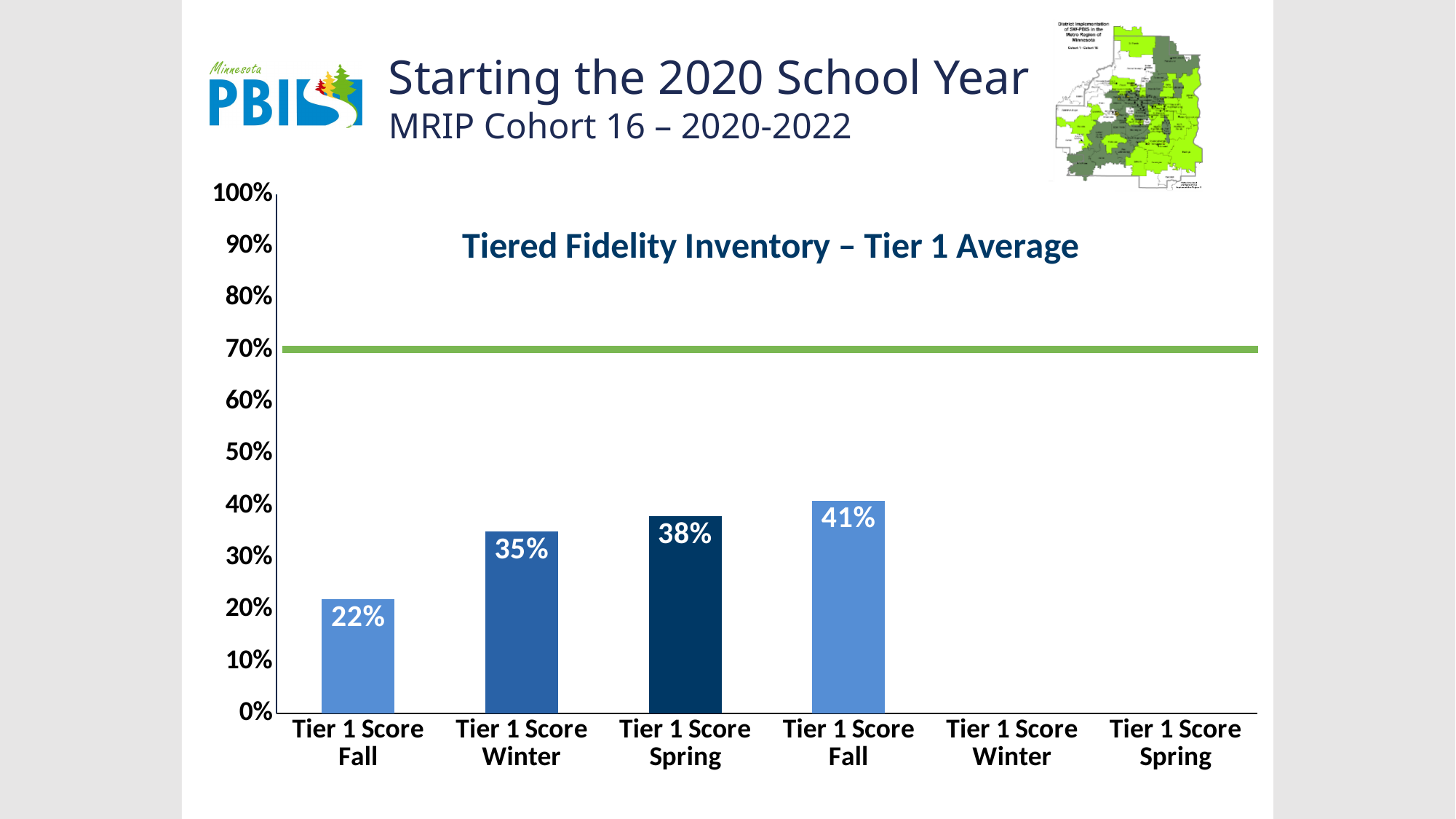
What is the difference between the fourth bar (41%) and the first bar (22%)? 19% Which is larger, the Tier 1 Score Winter bar or the Tier 1 Score Spring bar (third bar)? Tier 1 Score Spring What is the title of the chart? Tiered Fidelity Inventory – Tier 1 Average What is the value of the Tier 1 Score Spring bar (third from left)? 38% What is the value of the fourth bar, the second Tier 1 Score Fall? 41% What is the value of the first bar, Tier 1 Score Fall (leftmost)? 22% What kind of chart is shown on the slide? bar chart Which bar has the highest value? Tier 1 Score Fall (fourth bar) Is the value of the fourth bar (second Tier 1 Score Fall) greater or less than 70%? less What is the value of the Tier 1 Score Winter bar (second from left)? 35% How many category labels are shown on the x axis? 6 Which bar has the lowest value? Tier 1 Score Fall (first bar)